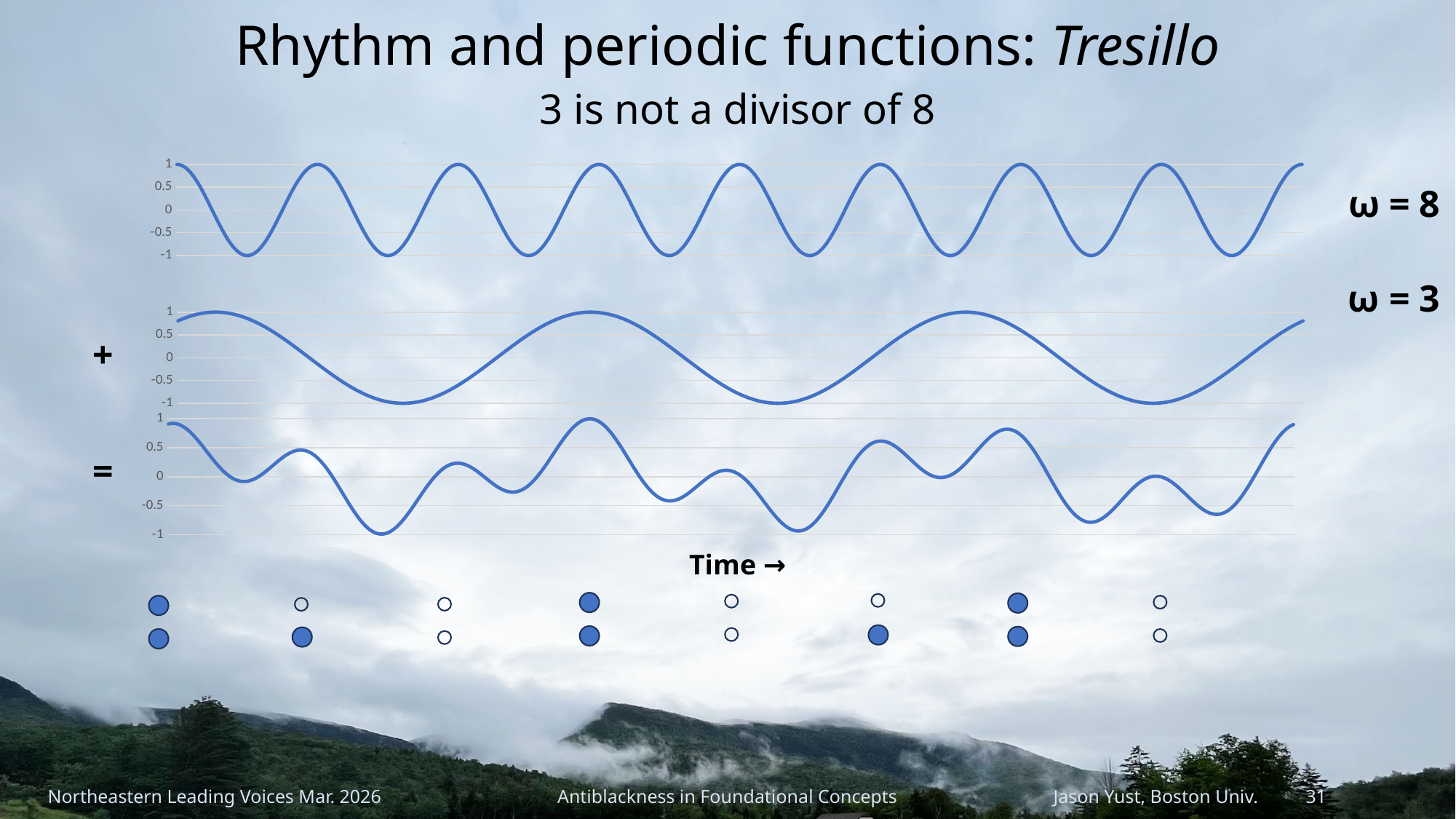
In the middle chart labelled ω = 3, how many peaks does the wave reach within the plotted range? 3 What is the highest value shown on the vertical axis of the top chart? 1 What label is written to the right of the top chart? ω = 8 What kind of chart is the top chart labelled ω = 8? line chart How many charts are shown on the slide? 3 In the bottom chart, is the value at the left edge of the plot greater or less than 0.5? greater What is the lowest value shown on the vertical axis of the bottom chart? -1 In the bottom chart, is the lowest trough of the wave greater or less than -0.5? less In the middle chart labelled ω = 3, is the value at the left edge of the plot greater or less than 0? greater Which chart has the wave with more oscillations across the plot, the one labelled ω = 8 or the one labelled ω = 3? ω = 8